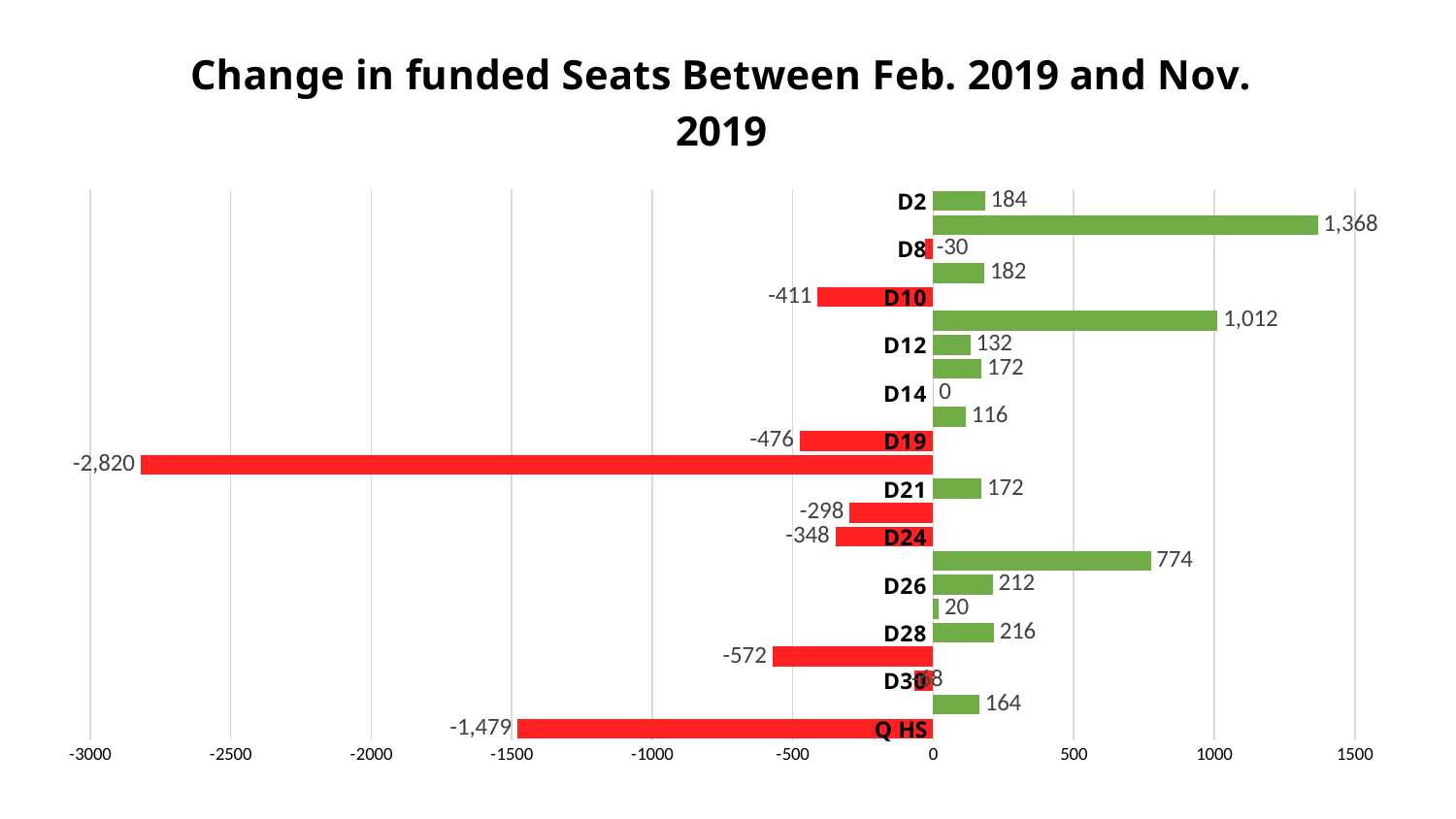
What is the change in funded seats for D26? 212 What is the difference between the values for D28 and D26? 4 Is the value for D10 greater or less than -500? greater What type of chart is shown on the slide? Bar chart What is the change in funded seats for D10? -411 What is the largest value shown on the chart? 1,368 What is the change in funded seats for D2? 184 What is the lowest value shown on the chart? -2,820 What is the change in funded seats for Q HS? -1,479 Which has the larger decrease in funded seats, D19 or D24? D19 What colour are the bars with negative values? Red What is the change in funded seats for D14? 0